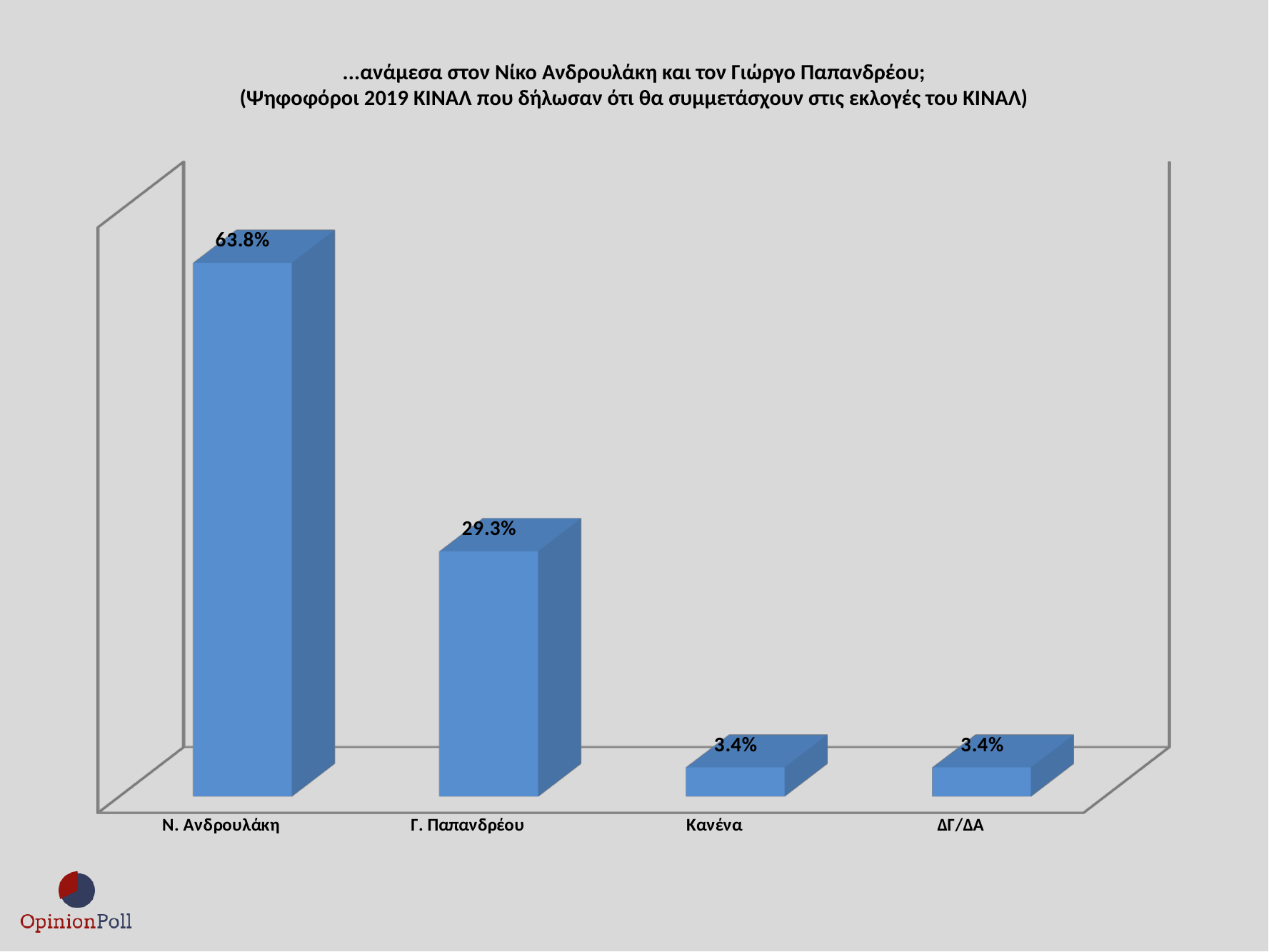
What is the value for Γ. Παπανδρέου? 29.3% What is the difference between the values for Γ. Παπανδρέου and ΔΓ/ΔΑ? 25.9% What kind of chart is shown on the slide? Bar chart Which is larger, the value for Γ. Παπανδρέου or the value for Κανένα? Γ. Παπανδρέου Which category has the highest value? Ν. Ανδρουλάκη What colour are the bars in the chart? Blue What is the value for Κανένα? 3.4% How many categories are shown on the chart? 4 What is the value for ΔΓ/ΔΑ? 3.4% What is the label of the third category from the left? Κανένα What is the value for Ν. Ανδρουλάκη? 63.8% What is the difference between the values for Ν. Ανδρουλάκη and Γ. Παπανδρέου? 34.5%